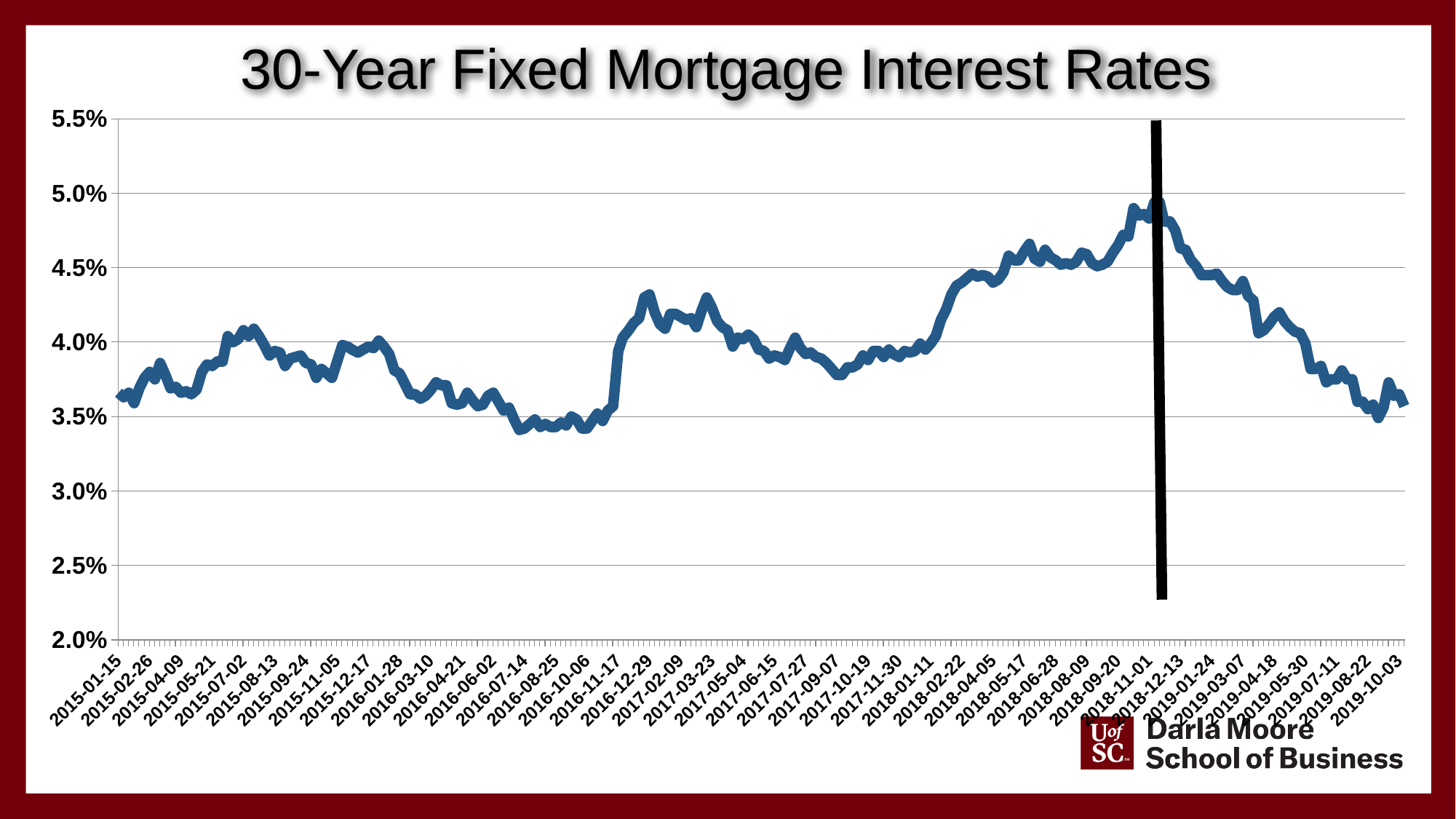
Do the values rise or fall between 2016-10-06 and 2016-12-29? rise Is the value for 2015-01-15 greater or less than 3.5%? greater What kind of chart is shown on the slide? line chart Is the value for 2017-02-09 greater or less than 4.0%? greater Which is larger, the value for 2016-07-14 or the value for 2018-11-01? 2018-11-01 Which is larger, the value for 2018-06-28 or the value for 2015-01-15? 2018-06-28 Is the value for 2018-11-01 greater or less than 4.5%? greater Do the values rise or fall between 2018-11-01 and 2019-10-03? fall In which year does the line reach its highest point? 2018 What is the title of the chart? 30-Year Fixed Mortgage Interest Rates